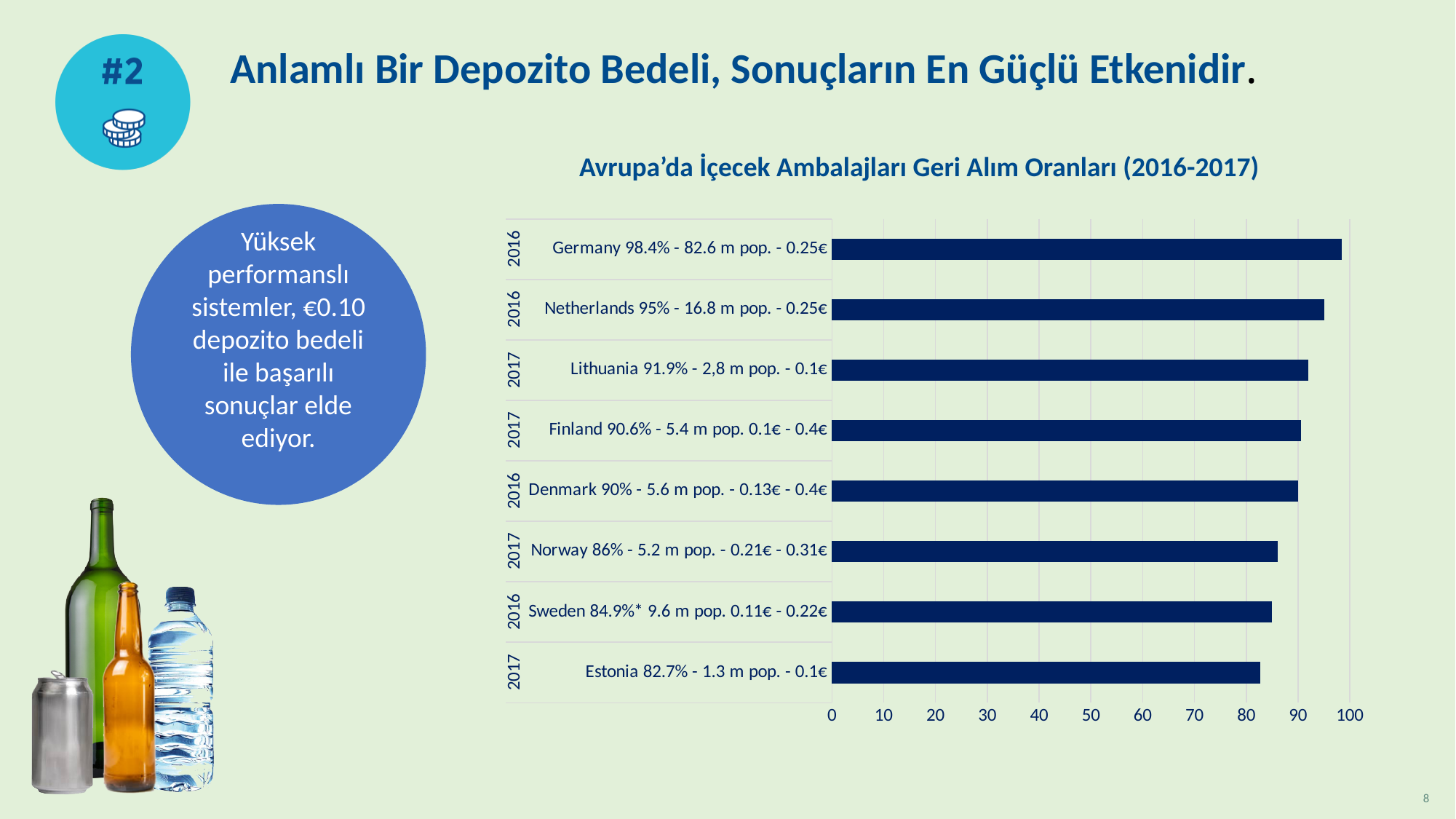
What is the return rate shown for Finland? 90.6% What is the return rate shown for Germany? 98.4% Which has a higher return rate, Lithuania or Denmark? Lithuania What is the return rate shown for Estonia? 82.7% What kind of chart is shown on the slide? Bar chart What is the difference in return rate between Germany and Estonia? 15.7 percentage points How many countries are shown in the chart? 8 What is the title of the chart? Avrupa'da İçecek Ambalajları Geri Alım Oranları (2016-2017) Which country has the lowest return rate in the chart? Estonia What is the difference in return rate between Netherlands and Norway? 9 percentage points Is the value for Norway greater or less than 90? less Which country has the highest return rate in the chart? Germany